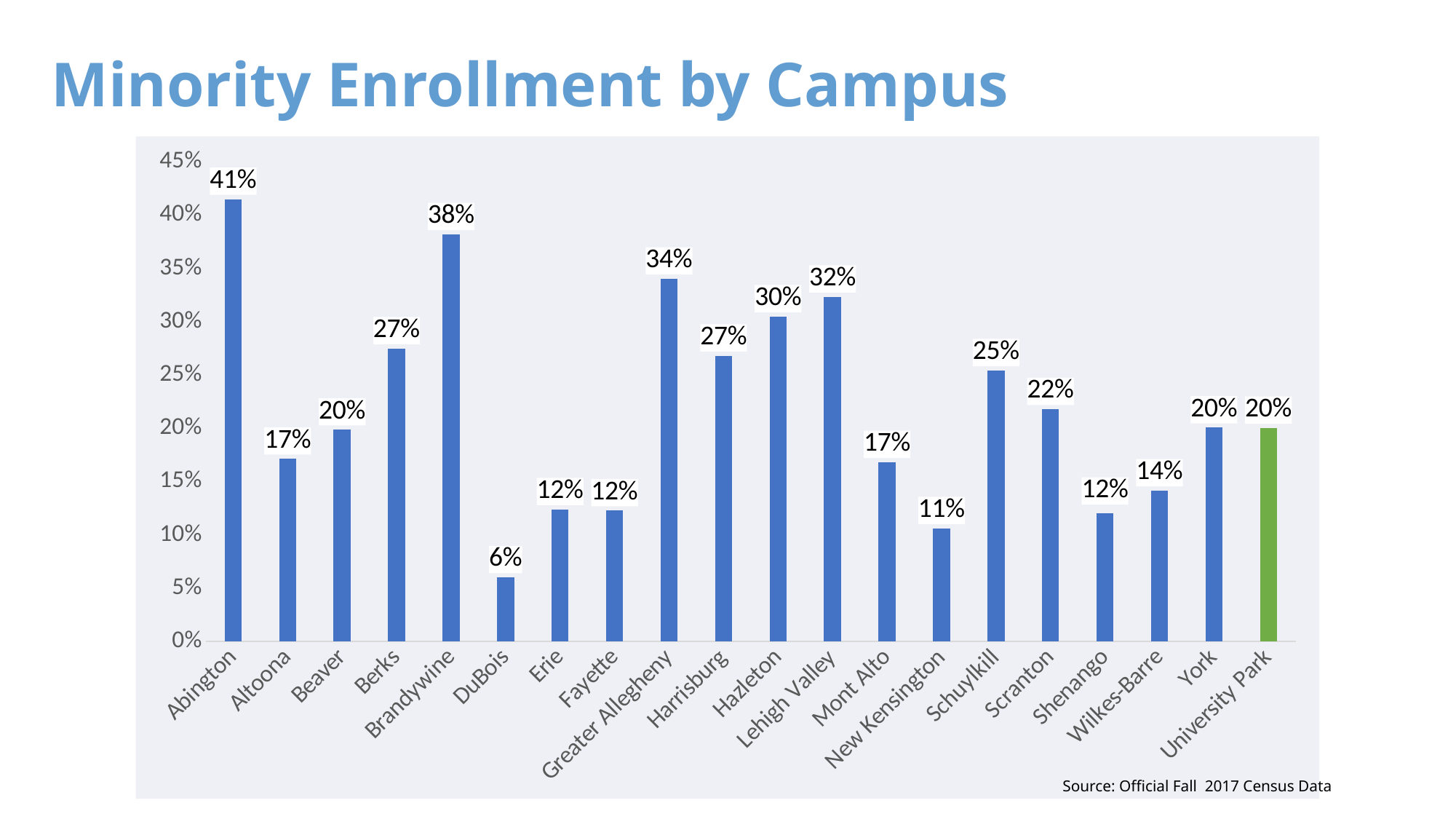
Which bar is shown in a different colour (green) from the others? University Park Which campus has the highest minority enrollment percentage? Abington What is the difference in minority enrollment between Abington and DuBois? 35% Which campus has the lowest minority enrollment percentage? DuBois What is the difference in minority enrollment between Brandywine and Hazleton? 8% What is the source cited for the chart data? Official Fall 2017 Census Data What kind of chart is shown on the slide? Bar chart Which campus has a higher minority enrollment percentage, Lehigh Valley or Schuylkill? Lehigh Valley What is the minority enrollment percentage for University Park? 20% What is the minority enrollment percentage for Greater Allegheny? 34% How many campuses are shown on the chart? 20 What is the minority enrollment percentage for Abington? 41%